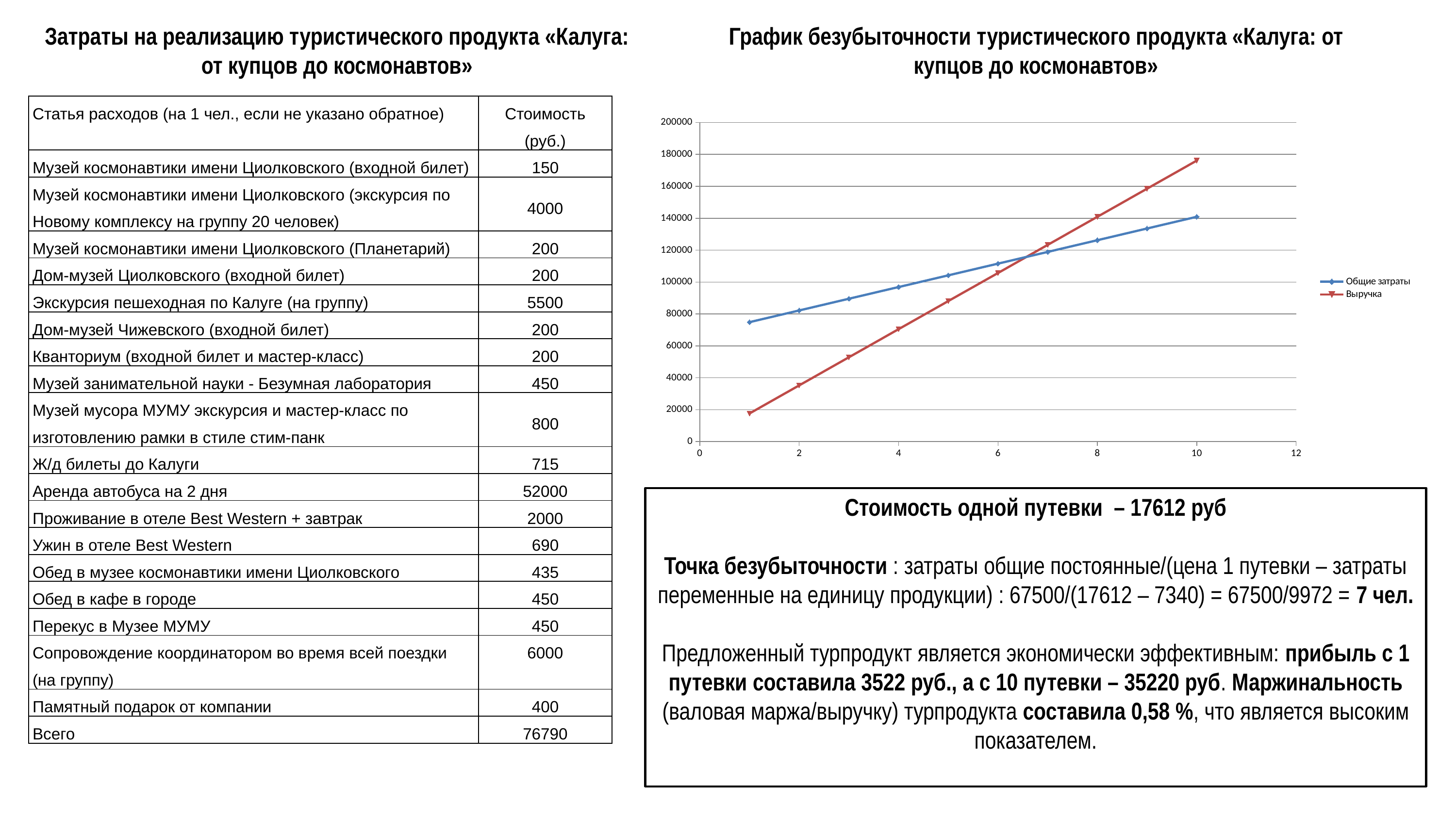
How many data points does the Выручка series have on the break-even chart? 10 On the break-even chart, which series has the larger value at x = 2, Общие затраты or Выручка? Общие затраты On the break-even chart, do the values of the Общие затраты series rise or fall as x increases? rise On the break-even chart, which series has the larger value at x = 10, Общие затраты or Выручка? Выручка On the break-even chart, is the Общие затраты value at x = 1 greater or less than 80000? less What are the two series named in the legend of the break-even chart? Общие затраты and Выручка What is the highest value shown on the vertical axis of the break-even chart? 200000 On the break-even chart, do the values of the Выручка series rise or fall as x increases? rise How many series does the legend of the break-even chart list? 2 What kind of chart is shown on the right side of the slide? line chart On the break-even chart, is the Выручка value at x = 10 greater or less than 160000? greater On the break-even chart, is the Выручка value at x = 1 greater or less than 20000? less